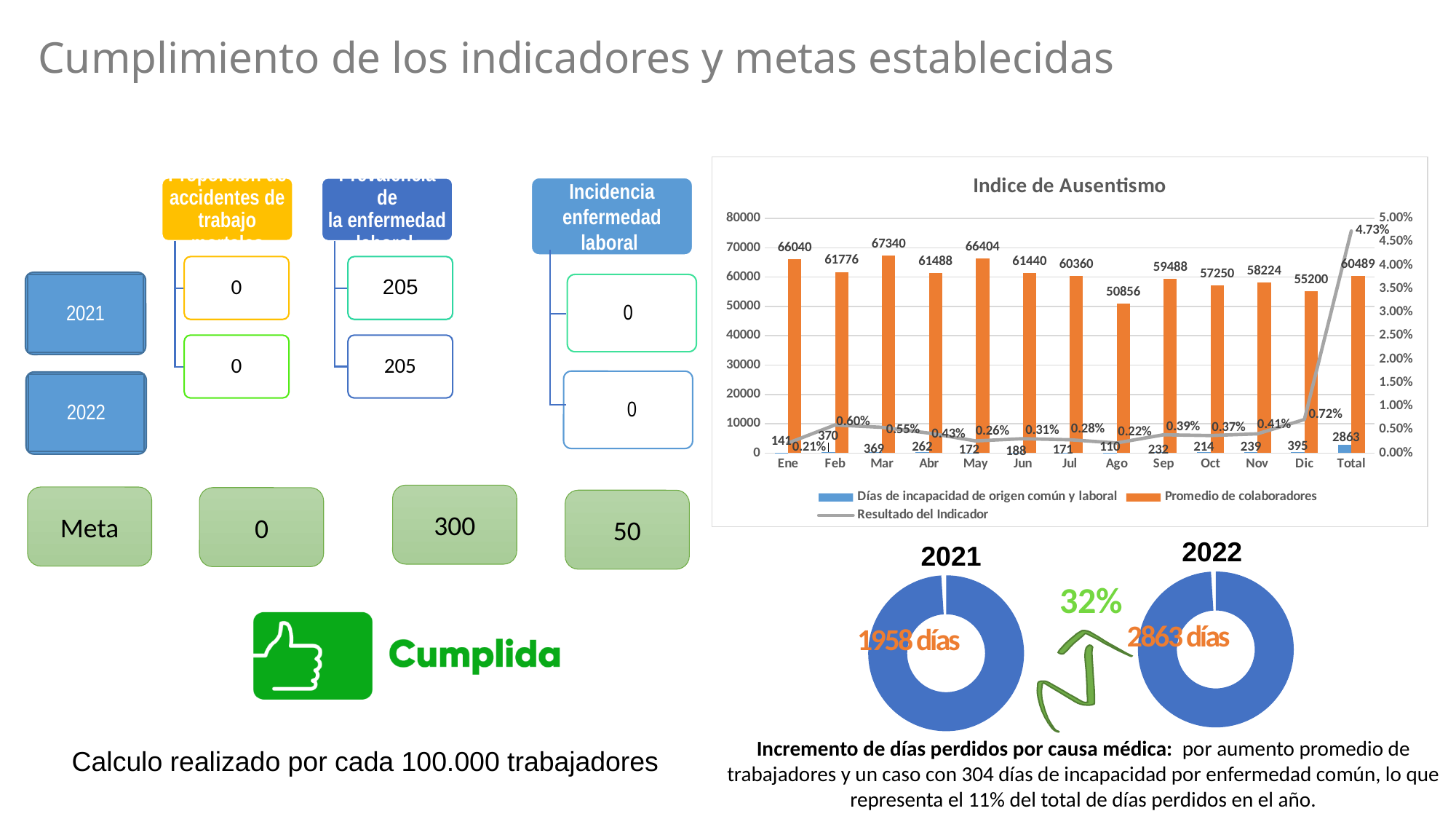
In the 'Indice de Ausentismo' chart, what is the 'Resultado del Indicador' value for Feb? 0.60% In the 'Indice de Ausentismo' chart, which month has the highest 'Promedio de colaboradores'? Mar In the 'Indice de Ausentismo' chart, how many categories are shown on the x axis? 13 In the 'Indice de Ausentismo' chart, which is larger: the 'Días de incapacidad' value for Feb or for Mar? Feb In the 'Indice de Ausentismo' chart, how many series does the legend list? 3 In the 'Indice de Ausentismo' chart, what is the 'Resultado del Indicador' value for Total? 4.73% What is the difference between the days shown in the 2022 donut chart and the 2021 donut chart? 905 In the 'Indice de Ausentismo' chart, what is the value of 'Días de incapacidad de origen común y laboral' for Dic? 395 In the 'Indice de Ausentismo' chart, what is the value of 'Promedio de colaboradores' for Mar? 67340 In the 'Indice de Ausentismo' chart, what is the difference between the 'Promedio de colaboradores' for Mar and for Ago? 16484 What value is shown in the 2021 donut chart at the bottom right of the slide? 1958 días In the 'Indice de Ausentismo' chart, which month has the lowest 'Promedio de colaboradores'? Ago